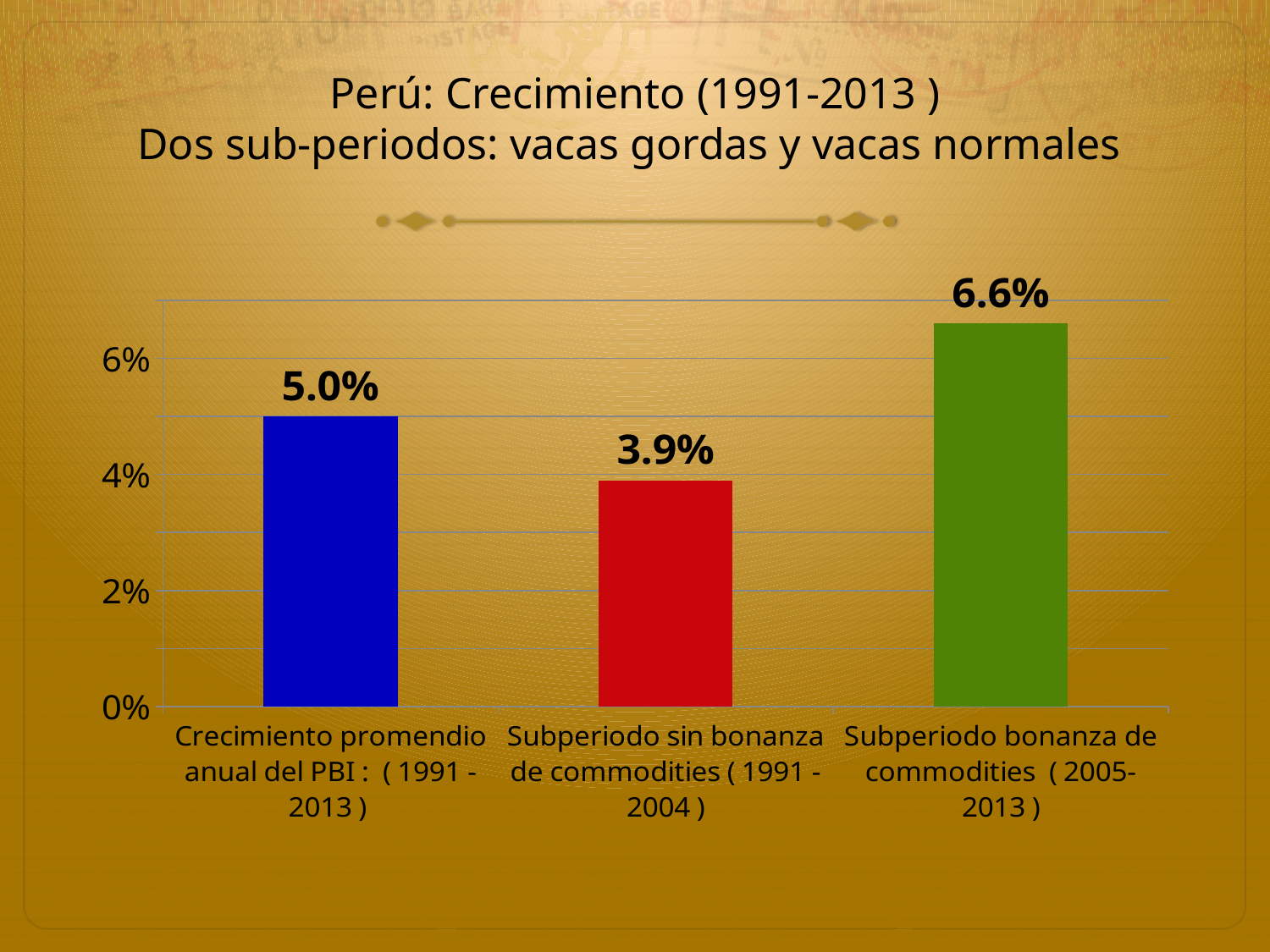
What is the difference between the value for 'Subperiodo bonanza de commodities ( 2005-2013 )' and the value for 'Subperiodo sin bonanza de commodities ( 1991 - 2004 )'? 2.7% What is the value for 'Crecimiento promendio anual del PBI : ( 1991 - 2013 )'? 5.0% What is the difference between the value for 'Subperiodo bonanza de commodities ( 2005-2013 )' and the value for 'Crecimiento promendio anual del PBI : ( 1991 - 2013 )'? 1.6% Which category has the lowest value? Subperiodo sin bonanza de commodities ( 1991 - 2004 ) What kind of chart is shown on the slide? bar chart Which category has the highest value? Subperiodo bonanza de commodities ( 2005-2013 ) What is the value for 'Subperiodo sin bonanza de commodities ( 1991 - 2004 )'? 3.9% How many categories are shown in the chart? 3 Is the value for 'Subperiodo bonanza de commodities ( 2005-2013 )' greater or less than 6%? greater Which is larger: the value for 'Crecimiento promendio anual del PBI : ( 1991 - 2013 )' or the value for 'Subperiodo sin bonanza de commodities ( 1991 - 2004 )'? Crecimiento promendio anual del PBI : ( 1991 - 2013 ) What is the value for 'Subperiodo bonanza de commodities ( 2005-2013 )'? 6.6% What colour is the bar for 'Subperiodo bonanza de commodities ( 2005-2013 )'? green